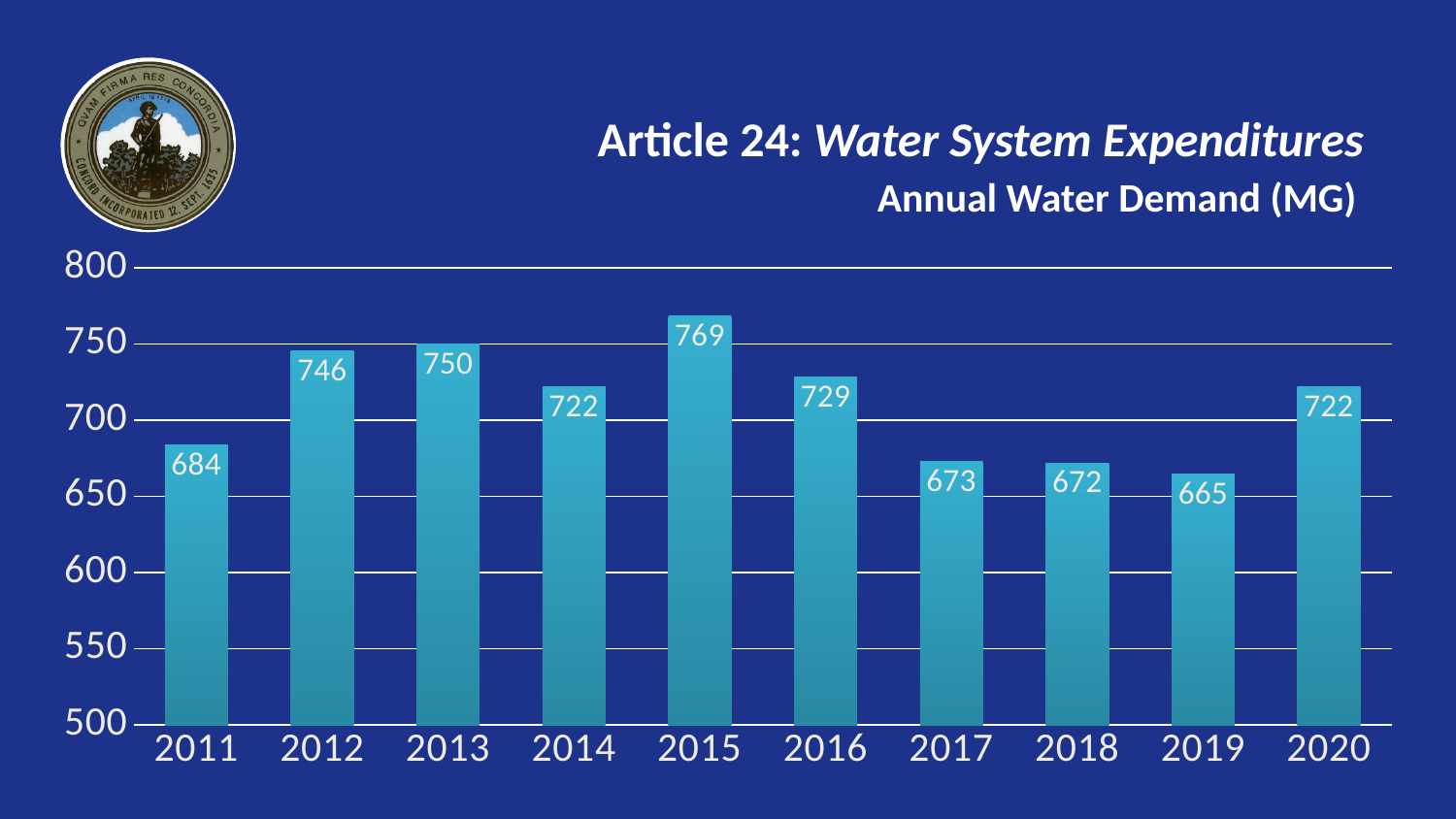
What was the annual water demand in 2011? 684 Which year had a higher annual water demand, 2016 or 2020? 2016 Which year had the lowest annual water demand? 2019 What was the annual water demand in 2015? 769 What is the difference in annual water demand between 2013 and 2012? 4 Is the value for 2014 greater or less than 700? greater What kind of chart is shown on the slide? Bar chart Which year had the highest annual water demand? 2015 What was the annual water demand in 2019? 665 What is the title of the chart? Annual Water Demand (MG) How many years are shown on the chart? 10 What is the difference in annual water demand between 2015 and 2019? 104